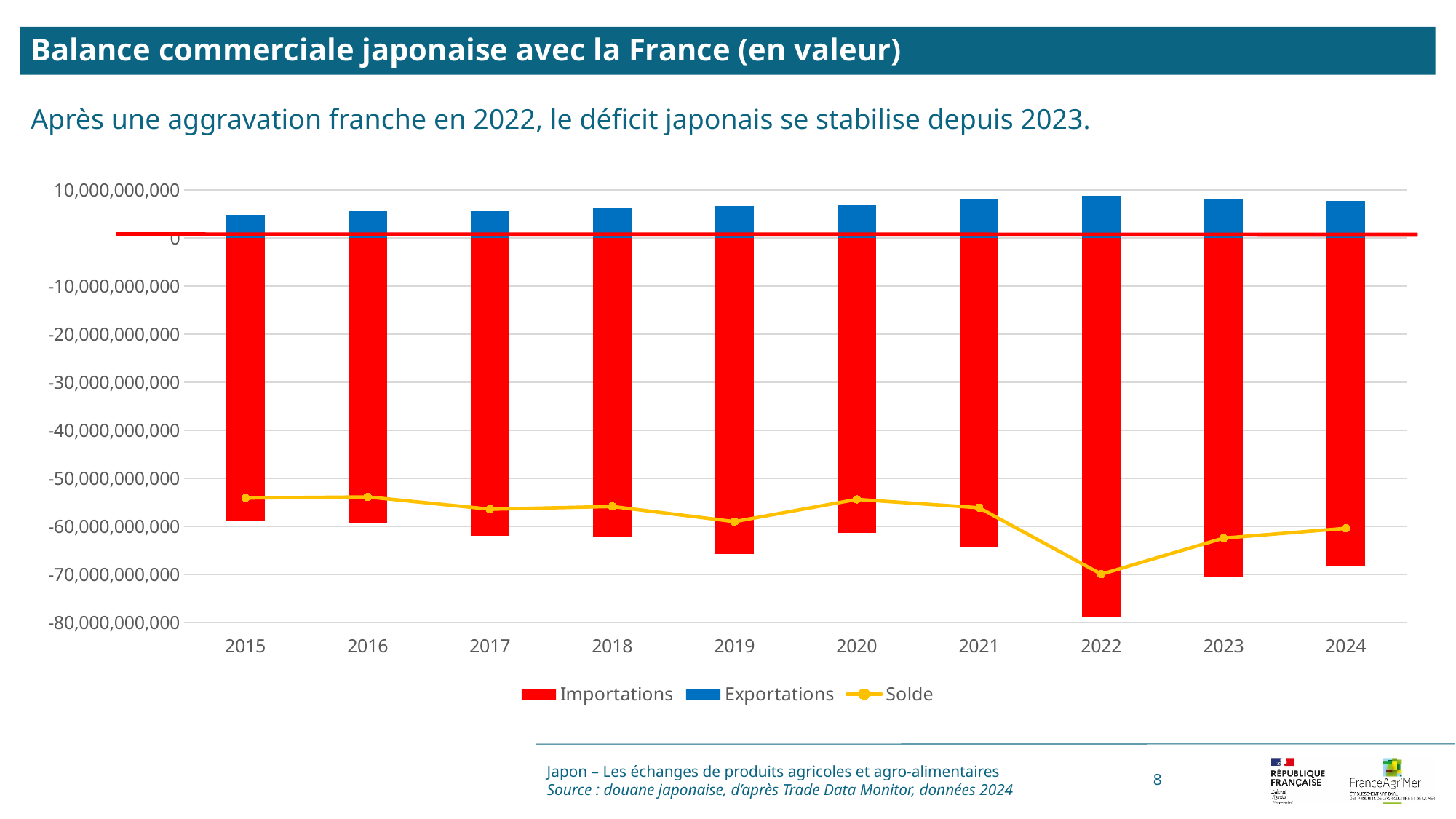
Is the Importations value for 2022 greater or less than -70,000,000,000? less In which year is the Solde line at its lowest point? 2022 Is the Importations value for 2021 greater or less than -60,000,000,000? less In which year is the Exportations bar the highest? 2022 What kind of chart is this? Bar chart with a line series Is the Solde value for 2023 greater or less than -60,000,000,000? less Which series is drawn in red? Importations How many series does the legend list? 3 In which year is the Importations bar the largest in magnitude (most negative)? 2022 Which year has the higher Solde value, 2020 or 2022? 2020 How many years are shown on the x axis? 10